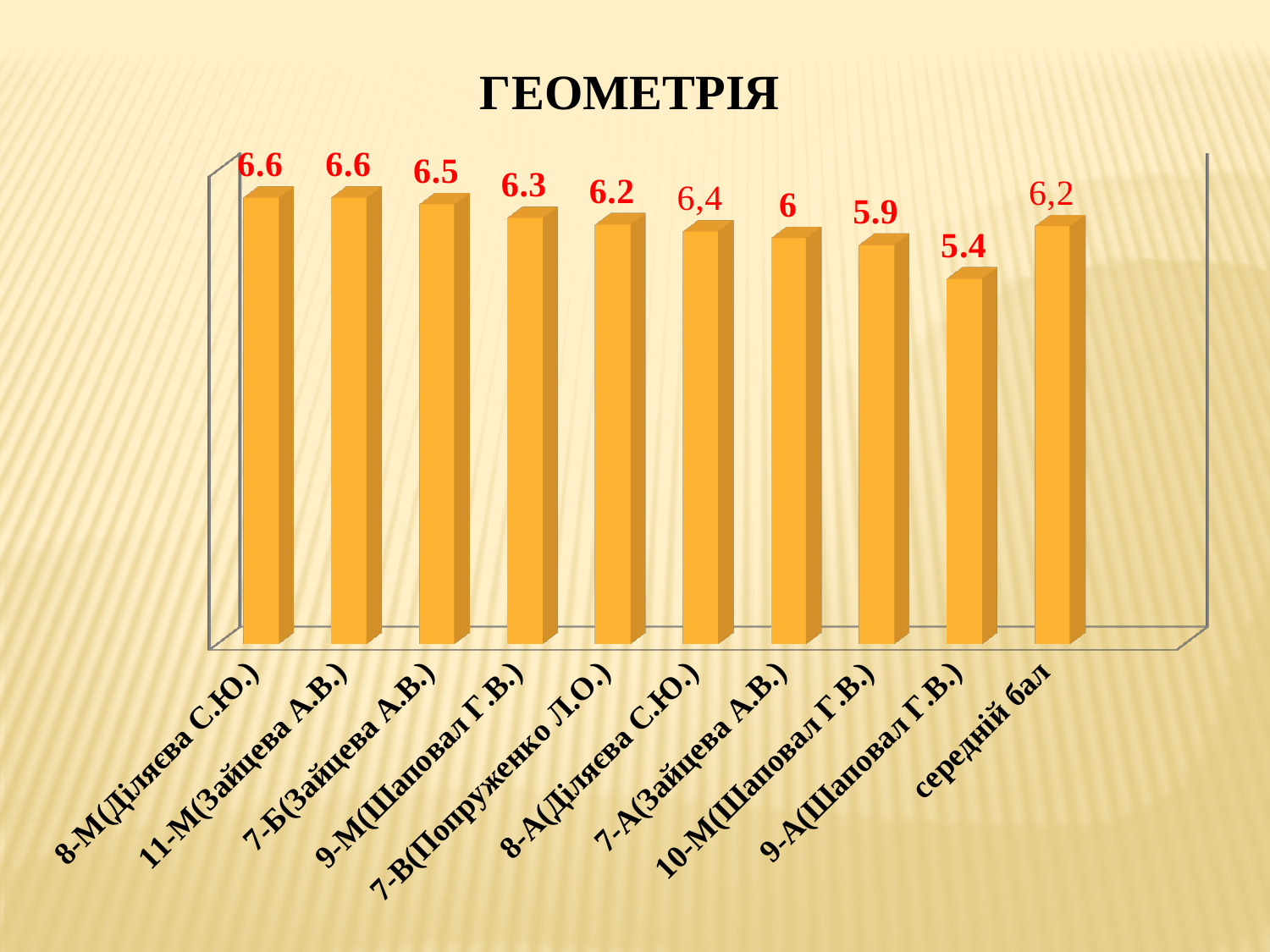
What is the value shown for середній бал? 6,2 Which is larger, the value for 7-Б(Зайцева А.В.) or the value for 10-М(Шаповал Г.В.)? 7-Б(Зайцева А.В.) What is the difference between the values for 8-М(Діляєва С.Ю.) and 9-А(Шаповал Г.В.)? 1.2 How many bars are shown in the chart? 10 What kind of chart is shown on the slide? bar chart What is the value for 10-М(Шаповал Г.В.)? 5.9 Which category has the lowest value? 9-А(Шаповал Г.В.) What is the difference between the values for 9-М(Шаповал Г.В.) and 7-А(Зайцева А.В.)? 0.3 What is the value for 9-А(Шаповал Г.В.)? 5.4 What is the value for 7-Б(Зайцева А.В.)? 6.5 What is the title of the chart? ГЕОМЕТРІЯ What is the value for 8-М(Діляєва С.Ю.)? 6.6